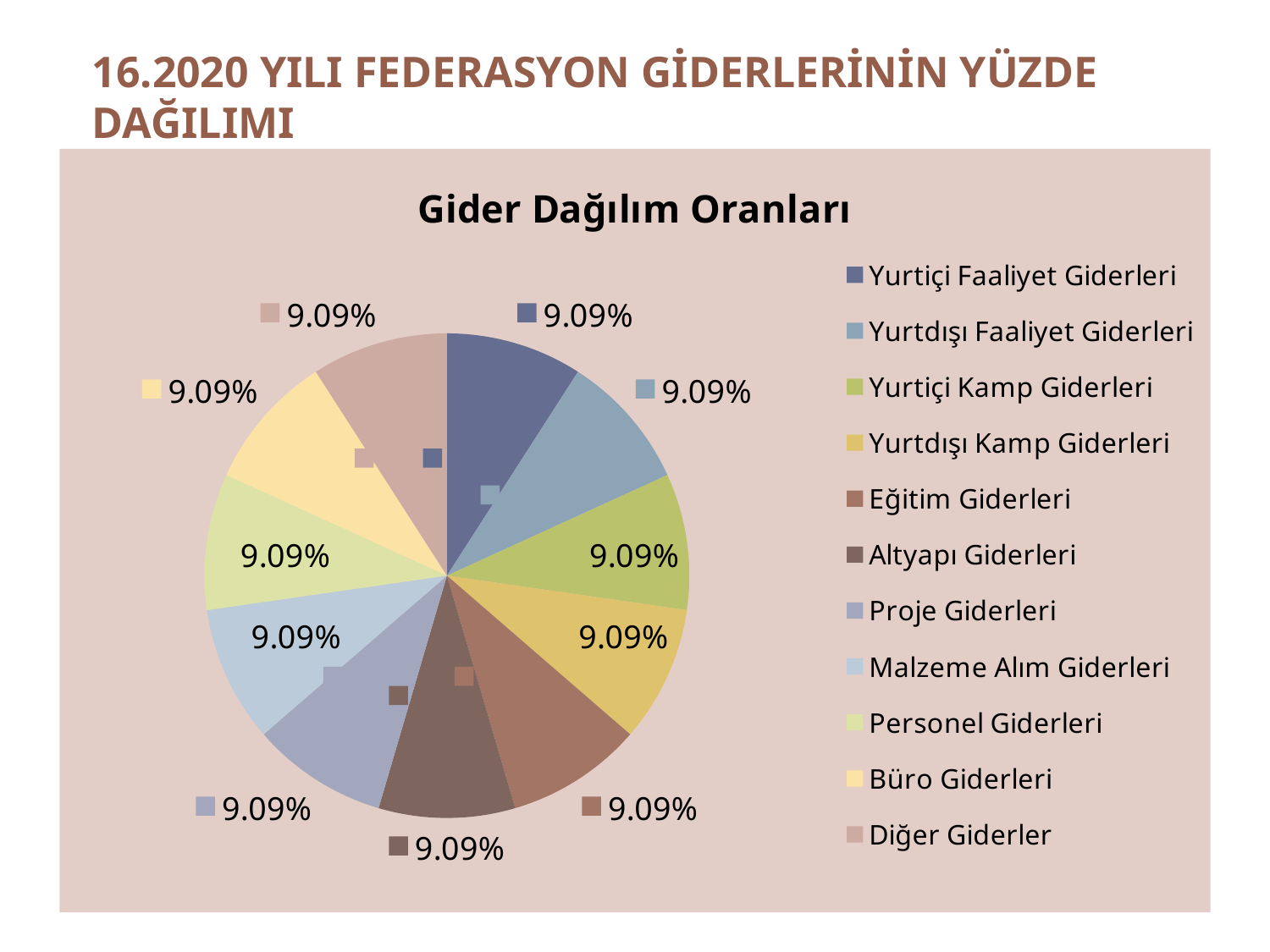
What is the value shown for Eğitim Giderleri? 9.09% What is the value shown for Altyapı Giderleri? 9.09% Is the value for Malzeme Alım Giderleri greater or less than 10%? less Which legend entry is listed last? Diğer Giderler What share of the pie does Yurtiçi Faaliyet Giderleri represent? 9.09% How many entries does the legend list? 11 What is the title of the chart? Gider Dağılım Oranları How many slices does the pie chart have? 11 What is the value shown for Diğer Giderler? 9.09% What kind of chart is shown on the slide? pie chart What is the difference between the values for Proje Giderleri and Büro Giderleri? 0% What is the value shown for Personel Giderleri? 9.09%